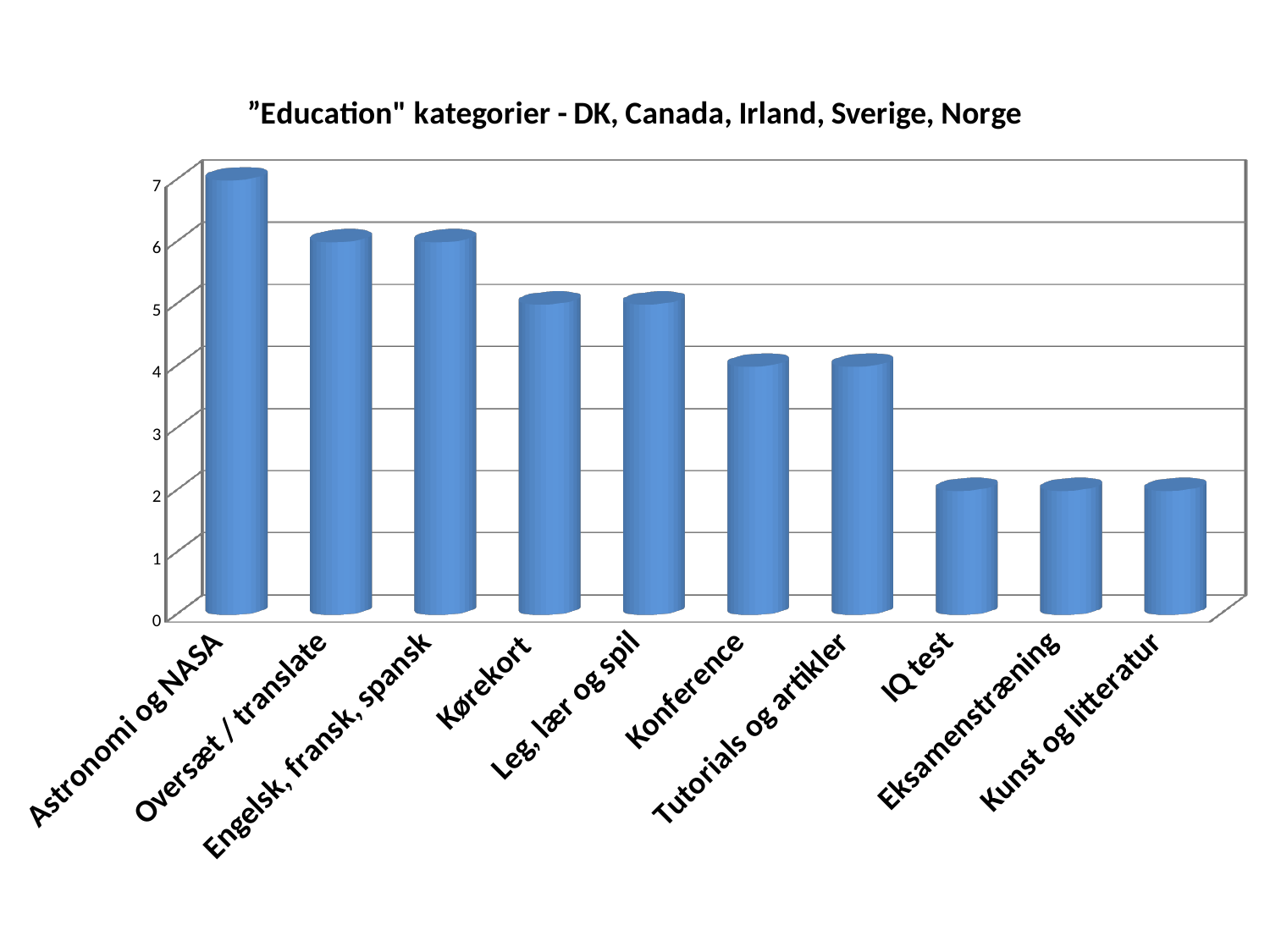
What is the value for Kørekort? 5 Which is larger, the value for Leg, lær og spil or the value for Eksamenstræning? Leg, lær og spil What kind of chart is shown on the slide? bar chart What is the title of the chart? "Education" kategorier - DK, Canada, Irland, Sverige, Norge Which category has the highest value in the chart? Astronomi og NASA How many categories are shown on the x axis of the chart? 10 Do the values generally rise or fall from left to right along the x axis? fall What is the value for IQ test? 2 Is the value for Oversæt / translate greater or less than 4? greater What is the value for Konference? 4 Is the value for Kunst og litteratur greater or less than 3? less What is the value for Astronomi og NASA? 7